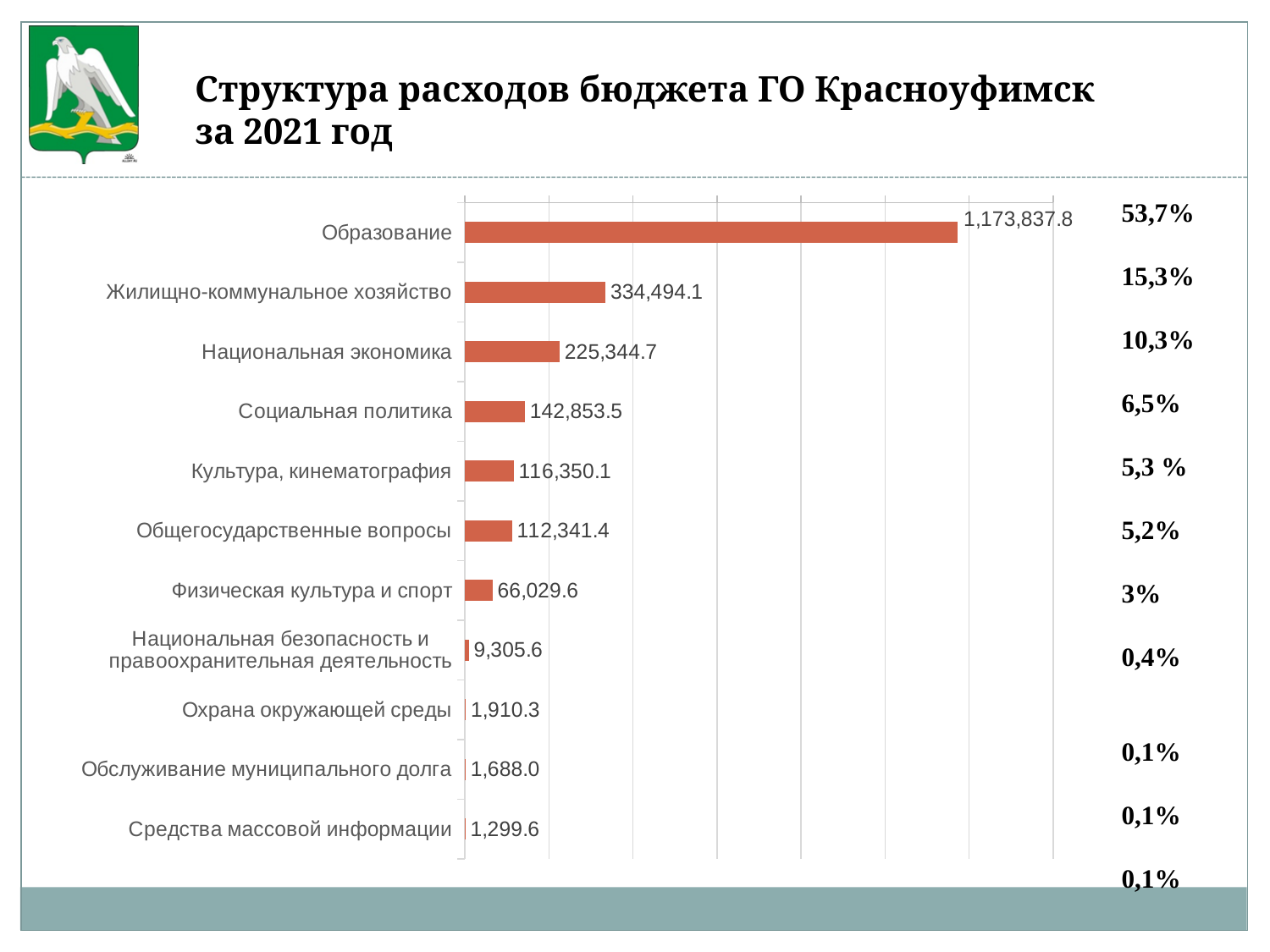
Which category has the lowest value? Средства массовой информации What is the value for Физическая культура и спорт? 66,029.6 Which is larger, the value for Культура, кинематография or the value for Общегосударственные вопросы? Культура, кинематография How many categories are shown in the chart? 11 What is the difference between the values for Охрана окружающей среды and Обслуживание муниципального долга? 222.3 What is the value for Средства массовой информации? 1,299.6 Which category has the highest value? Образование What is the title of the slide containing the chart? Структура расходов бюджета ГО Красноуфимск за 2021 год What kind of chart is shown on the slide? Bar chart What is the value for Жилищно-коммунальное хозяйство? 334,494.1 What is the value for Образование? 1,173,837.8 What is the difference between the values for Национальная экономика and Социальная политика? 82,491.2